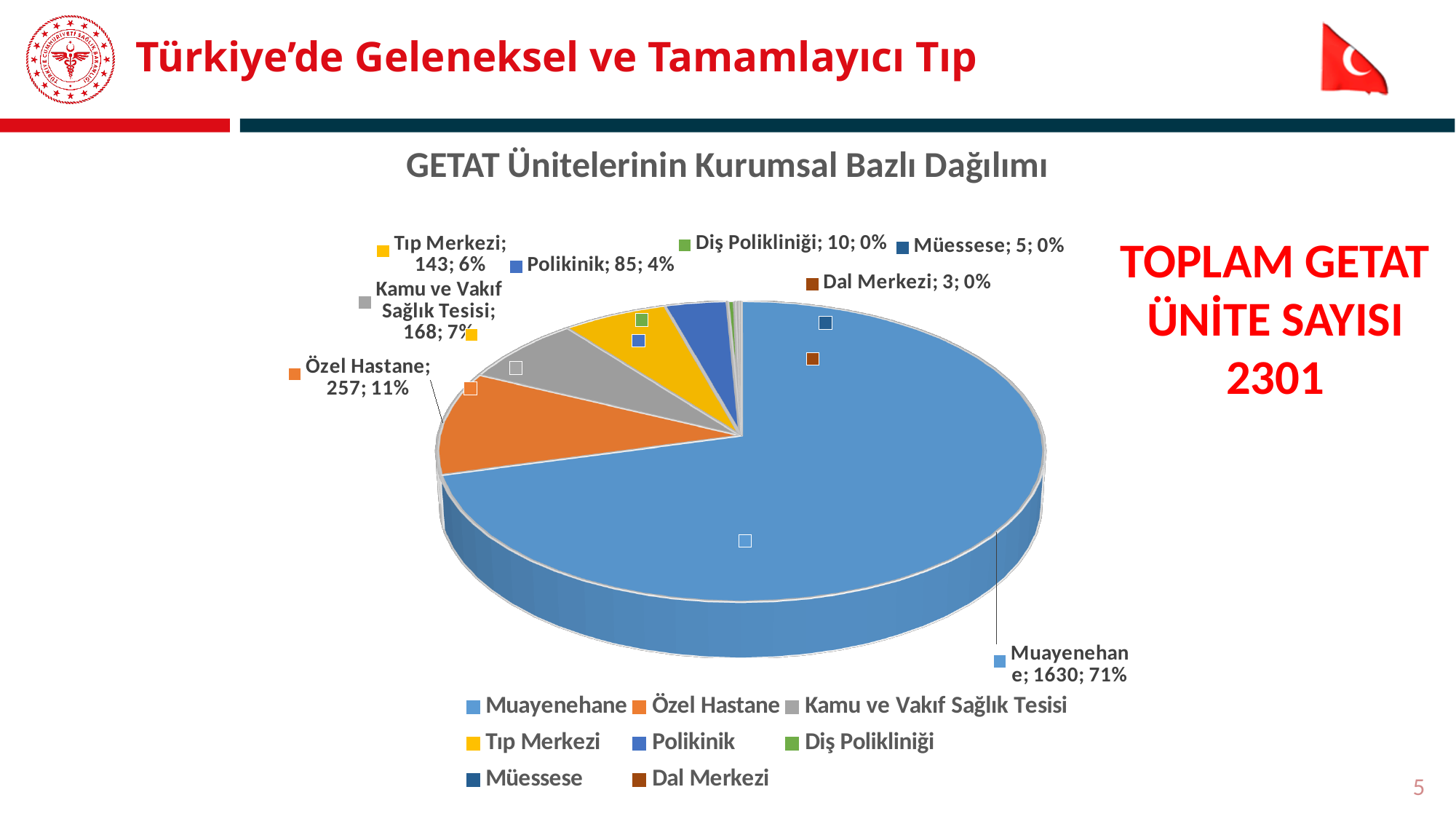
What kind of chart is shown on the slide? Pie chart Which is larger, the value for Kamu ve Vakıf Sağlık Tesisi or the value for Tıp Merkezi? Kamu ve Vakıf Sağlık Tesisi What is the value for Poliklinik? 85 Which category has the largest slice of the pie? Muayenehane What is the difference between the values for Tıp Merkezi and Poliklinik? 58 What is the title of the chart? GETAT Ünitelerinin Kurumsal Bazlı Dağılımı Which category has the smallest value? Dal Merkezi What share of the pie does Özel Hastane represent? 11% How many categories does the pie chart have? 8 What is the value for Muayenehane? 1630 What is the value for Kamu ve Vakıf Sağlık Tesisi? 168 What is the value for Özel Hastane? 257